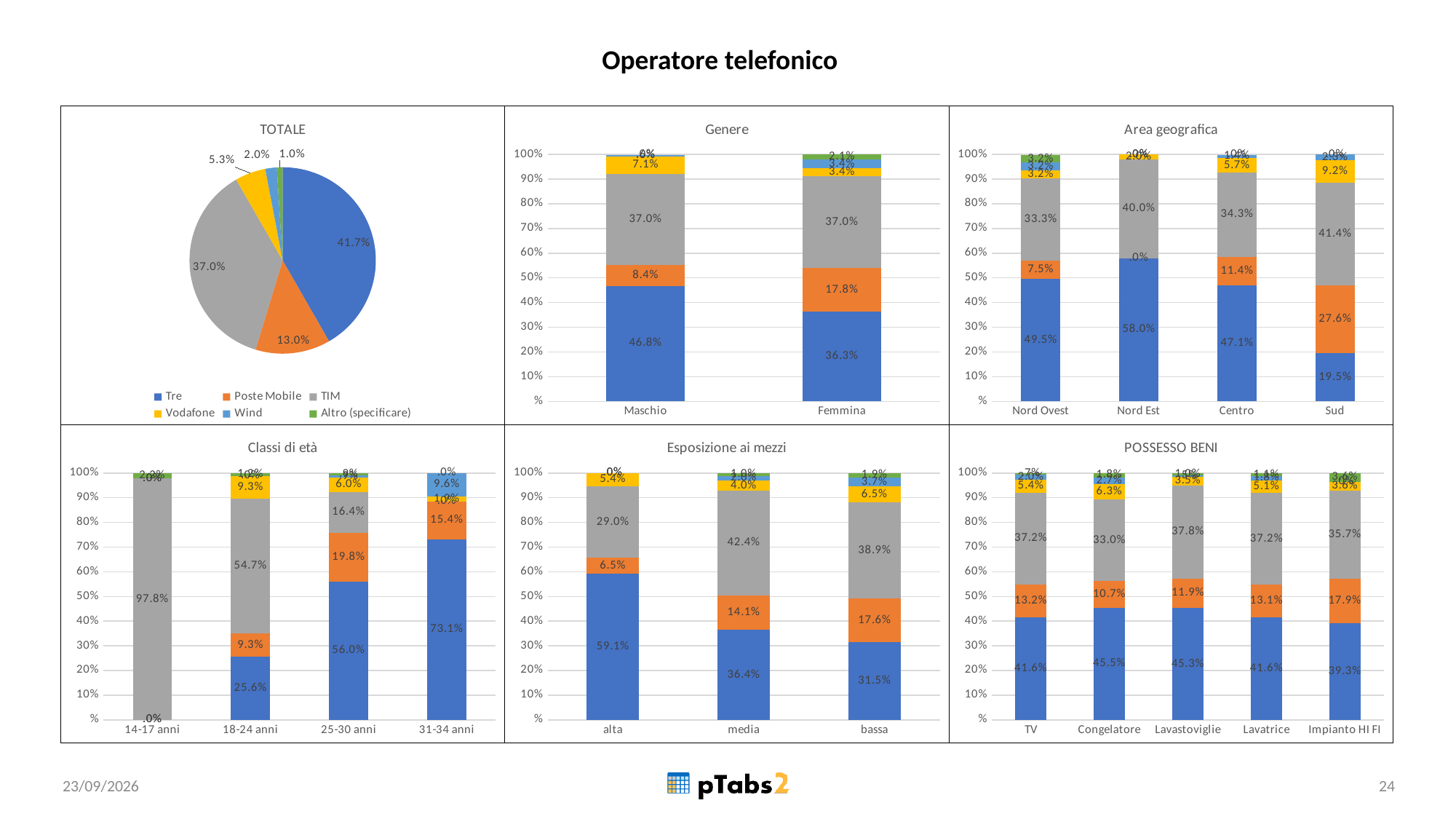
In the Genere chart, what is the difference between the Tre values for Maschio and Femmina? 10.5% In the TOTALE chart, what share of the pie does TIM have? 37.0% What kind of chart is the TOTALE chart? pie chart In the Genere chart, what is the value of Poste Mobile for Femmina? 17.8% In the POSSESSO BENI chart, is the Poste Mobile value for Impianto HI FI larger or smaller than the Poste Mobile value for Congelatore? larger In the POSSESSO BENI chart, which category has the lowest Tre value? Impianto HI FI In the Esposizione ai mezzi chart, does the Tre value rise or fall from alta to bassa? fall In the Classi di età chart, how many age categories are shown on the x axis? 4 How many series does the legend of the TOTALE chart list? 6 In the Area geografica chart, what is the Poste Mobile value for Sud? 27.6% In the Area geografica chart, which area has the highest Tre value? Nord Est In the Classi di età chart, what is the TIM value for 14-17 anni? 97.8%